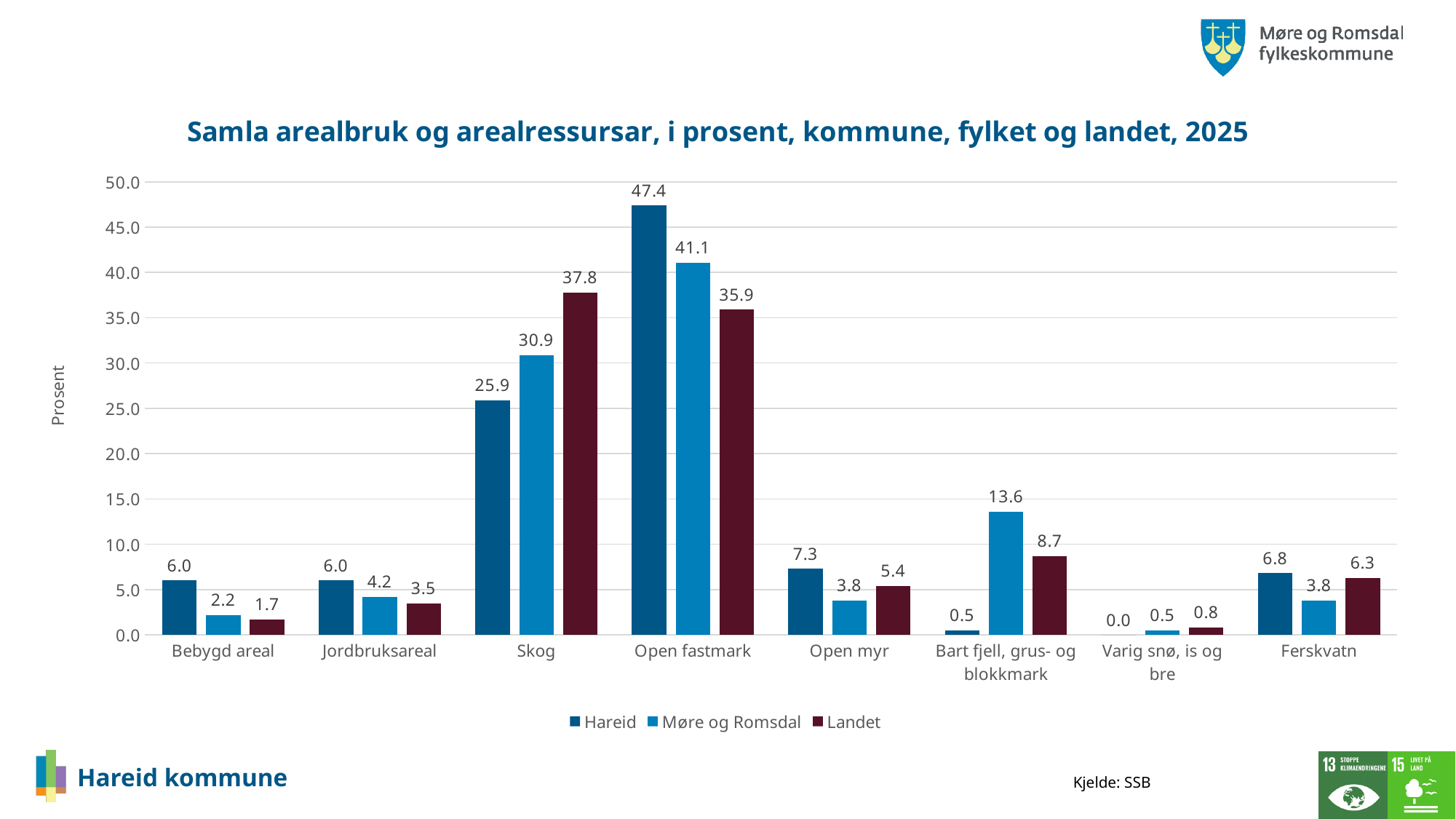
Which category has the highest value for Hareid? Open fastmark What is the label of the y axis? Prosent What is the difference between the Hareid and Landet values for Skog? 11.9 What is the value for Møre og Romsdal in the Bart fjell, grus- og blokkmark category? 13.6 Is the value for Møre og Romsdal in Open fastmark greater or less than 40.0? greater How many series does the legend list? 3 What kind of chart is shown on the slide? Bar chart Which is larger for Open myr: the value for Hareid or the value for Landet? Hareid Which category has the lowest value for Hareid? Varig snø, is og bre What is the value for Hareid in the Skog category? 25.9 How many categories are shown on the x axis? 8 What is the value for Landet in the Open fastmark category? 35.9